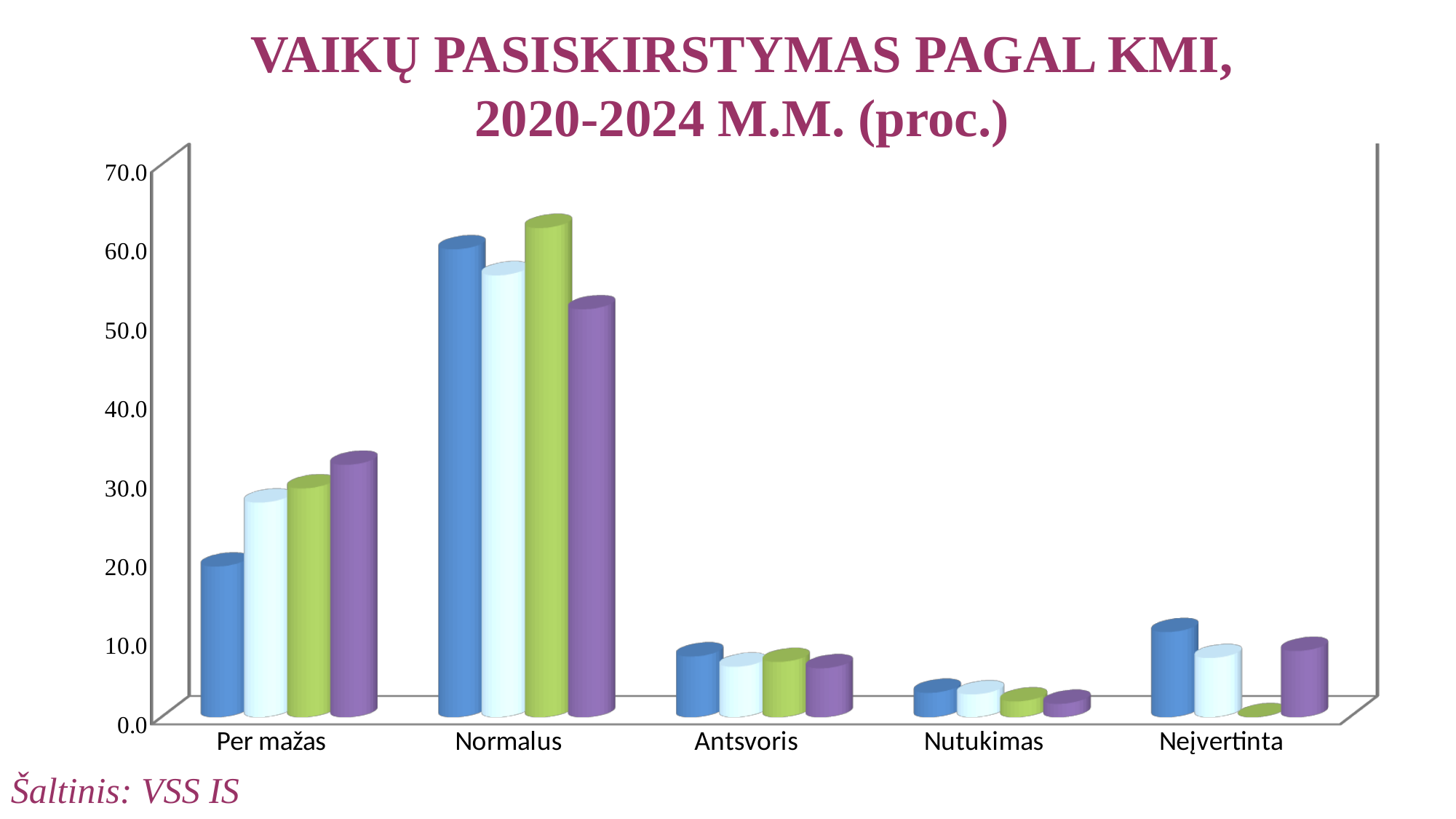
Within the Normalus category, which is larger: the green bar or the purple bar? the green bar Is the value of the blue bar for Per mažas greater or less than 30? less Is the value of the blue bar for Normalus greater or less than 50? greater How many bars are plotted for each category? 4 Is the value of the purple bar for Per mažas greater or less than 40? less What source is cited below the chart? VSS IS Within the Per mažas category, do the bars rise or fall from left to right? rise Which category has the tallest bars? Normalus Which category has the lowest bars overall? Nutukimas How many categories are shown on the x axis? 5 What kind of chart is shown on the slide? bar chart